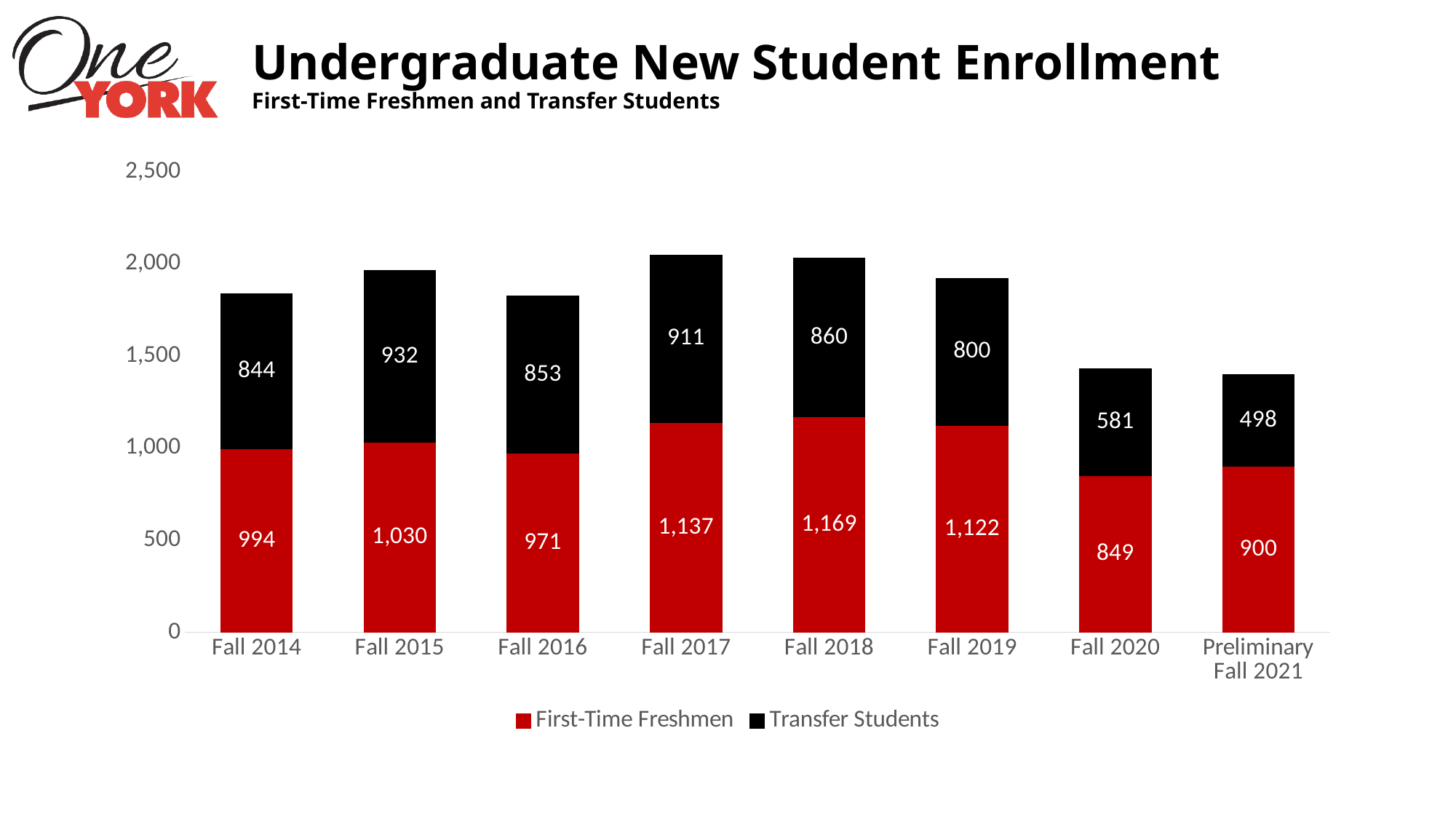
What is the number of First-Time Freshmen in Fall 2017? 1,137 What is the difference between First-Time Freshmen in Fall 2015 and Fall 2016? 59 What kind of chart is shown on the slide? Stacked bar chart Is the total enrollment for Fall 2017 greater or less than 2,000? greater What colour represents Transfer Students in the chart? Black Which period has the lowest number of Transfer Students? Preliminary Fall 2021 How many series does the legend list? 2 What is the number of Transfer Students in Fall 2020? 581 How many periods are shown on the x axis? 8 What is the total enrollment (First-Time Freshmen plus Transfer Students) for Fall 2019? 1,922 Which is larger: Transfer Students in Fall 2014 or Transfer Students in Fall 2016? Fall 2016 Which period has the highest number of First-Time Freshmen? Fall 2018